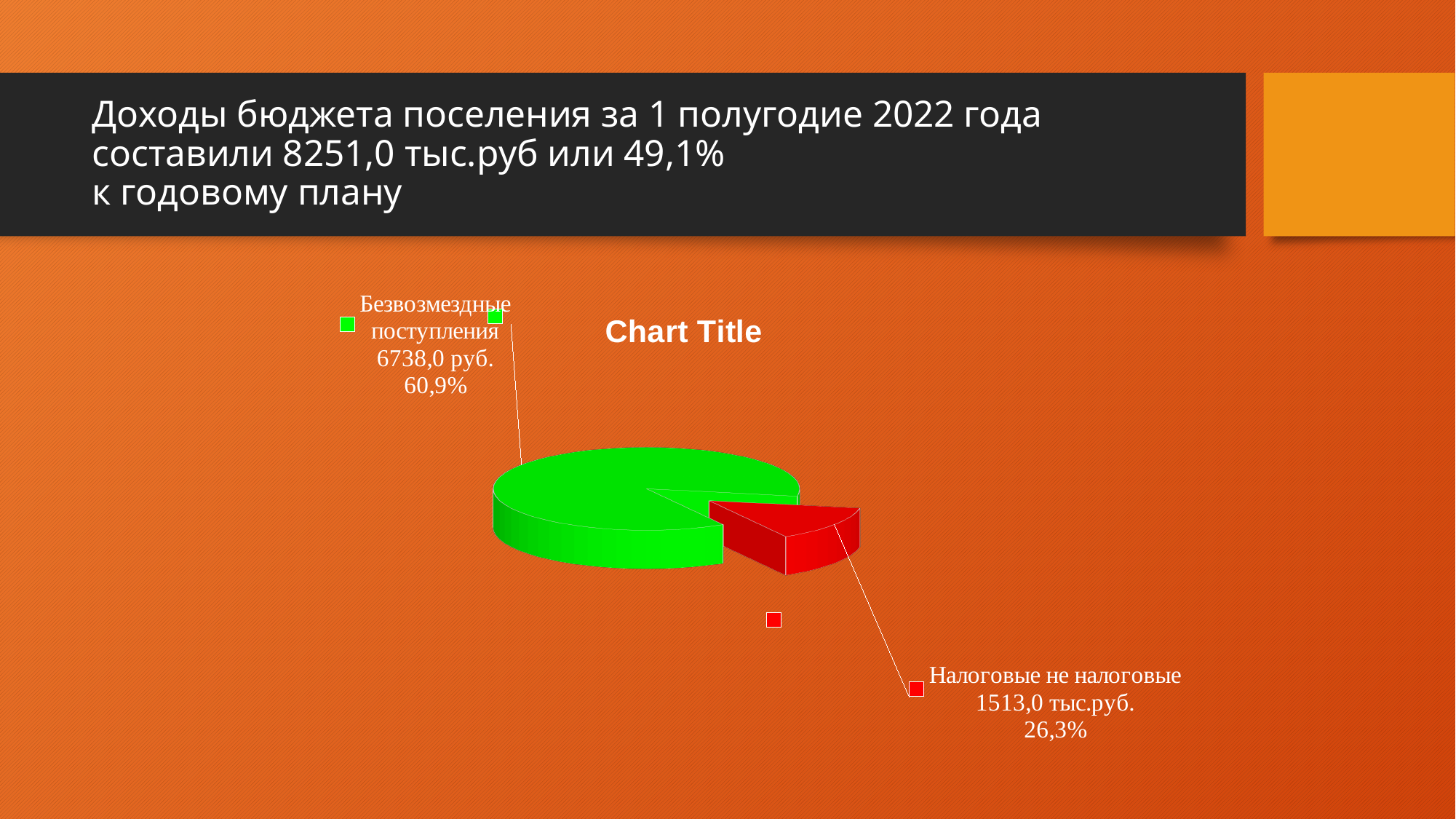
Which slice of the pie chart is the largest? Безвозмездные поступления What percentage is printed for the slice "Безвозмездные поступления"? 60,9% How many slices does the pie chart have? 2 What is the difference between the values for "Безвозмездные поступления" (6738,0) and "Налоговые не налоговые" (1513,0)? 5225,0 What value is labelled for the slice "Налоговые не налоговые"? 1513,0 тыс.руб. Which slice of the pie chart is the smallest? Налоговые не налоговые What value is labelled for the slice "Безвозмездные поступления"? 6738,0 руб. What percentage is printed for the slice "Налоговые не налоговые"? 26,3% Which is larger: the value for "Безвозмездные поступления" or for "Налоговые не налоговые"? Безвозмездные поступления What kind of chart is shown on the slide? pie chart What colour is the slice for "Налоговые не налоговые"? red What is the title printed above the pie chart? Chart Title